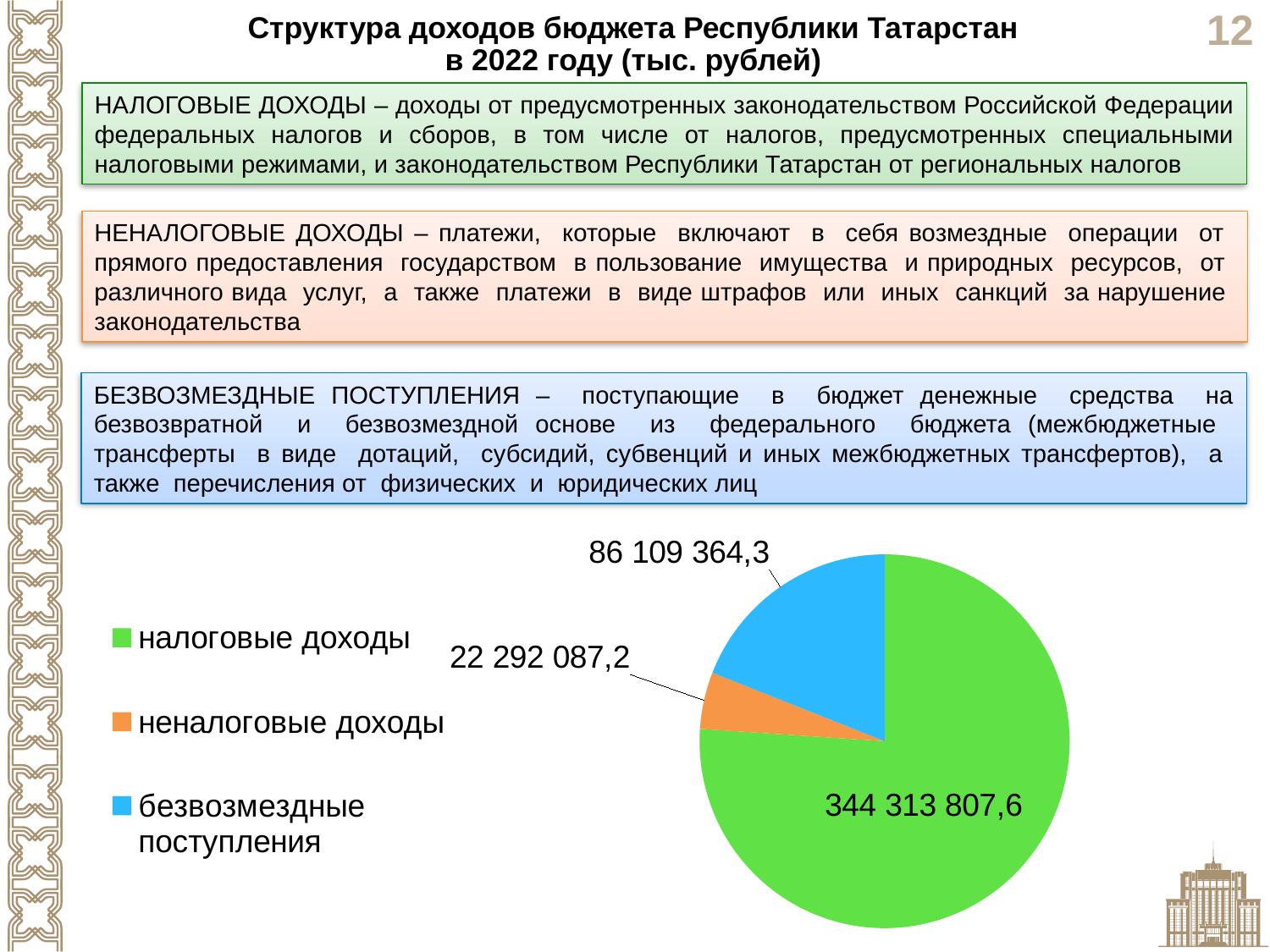
Which category has the largest slice in the pie chart? налоговые доходы What type of chart is shown on the slide? pie chart Which category has the smallest slice in the pie chart? неналоговые доходы What is the value for налоговые доходы in the pie chart? 344 313 807,6 What is the difference between безвозмездные поступления and неналоговые доходы? 63 817 277,1 What is the difference between налоговые доходы and безвозмездные поступления? 258 204 443,3 What is the value for безвозмездные поступления in the pie chart? 86 109 364,3 Which is larger: безвозмездные поступления or неналоговые доходы? безвозмездные поступления What is the total of all three slices in the pie chart? 452 715 259,1 What is the value for неналоговые доходы in the pie chart? 22 292 087,2 How many categories does the pie chart show? 3 What colour is the slice for безвозмездные поступления? blue